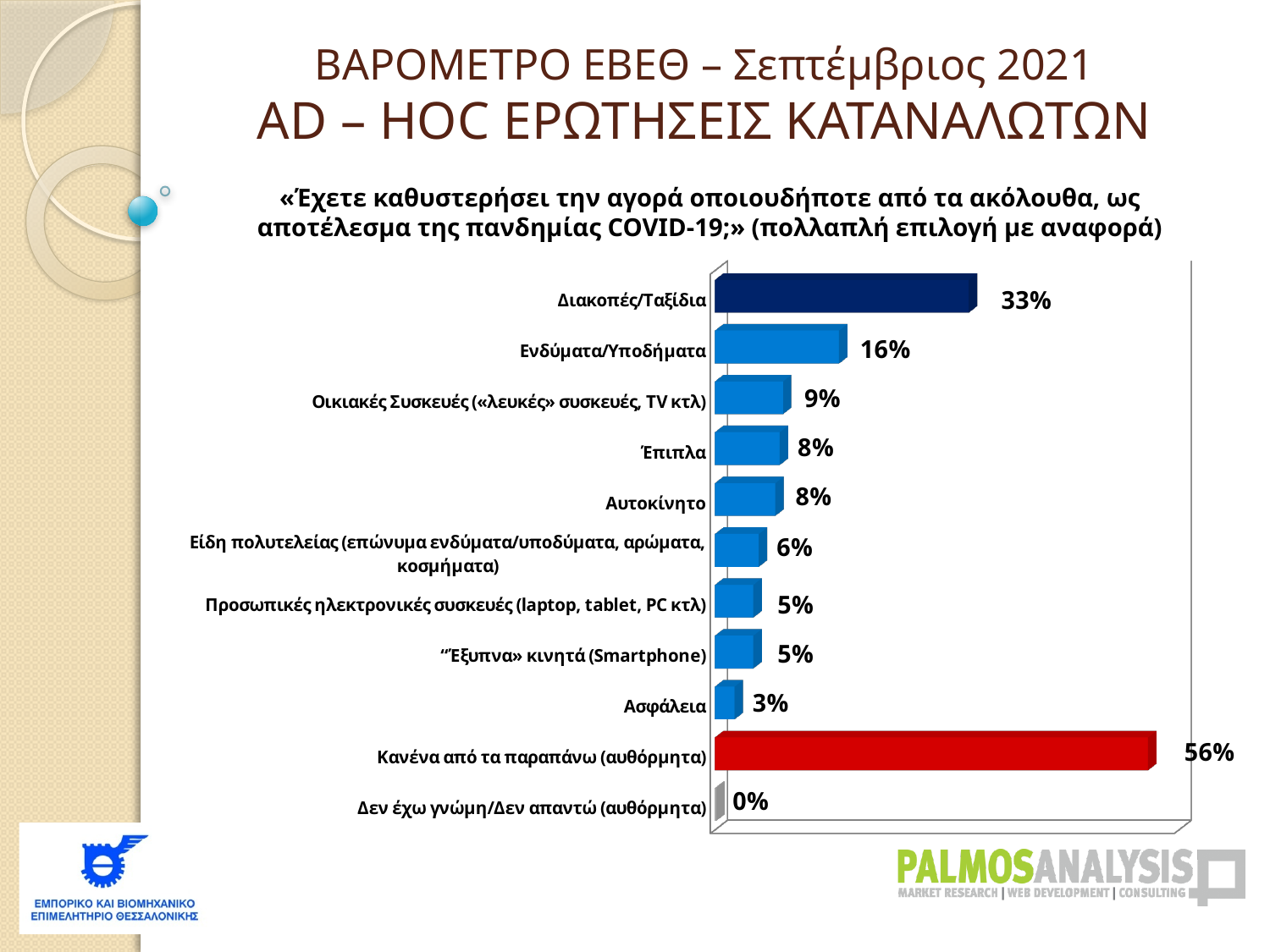
What is the value for Ενδύματα/Υποδήματα? 16% Which category has the highest value? Κανένα από τα παραπάνω (αυθόρμητα) What kind of chart is shown on the slide? Bar chart What is the value for Αυτοκίνητο? 8% What is the difference between the values for Διακοπές/Ταξίδια and Ενδύματα/Υποδήματα? 17% What is the value for Κανένα από τα παραπάνω (αυθόρμητα)? 56% What is the value for Διακοπές/Ταξίδια? 33% Which category has the lowest value? Δεν έχω γνώμη/Δεν απαντώ (αυθόρμητα) How many categories are shown in the chart? 11 What is the value for Ασφάλεια? 3% Which bar is coloured red? Κανένα από τα παραπάνω (αυθόρμητα) Which is larger, the value for Οικιακές Συσκευές («λευκές» συσκευές, TV κτλ) or the value for Έπιπλα? Οικιακές Συσκευές («λευκές» συσκευές, TV κτλ)